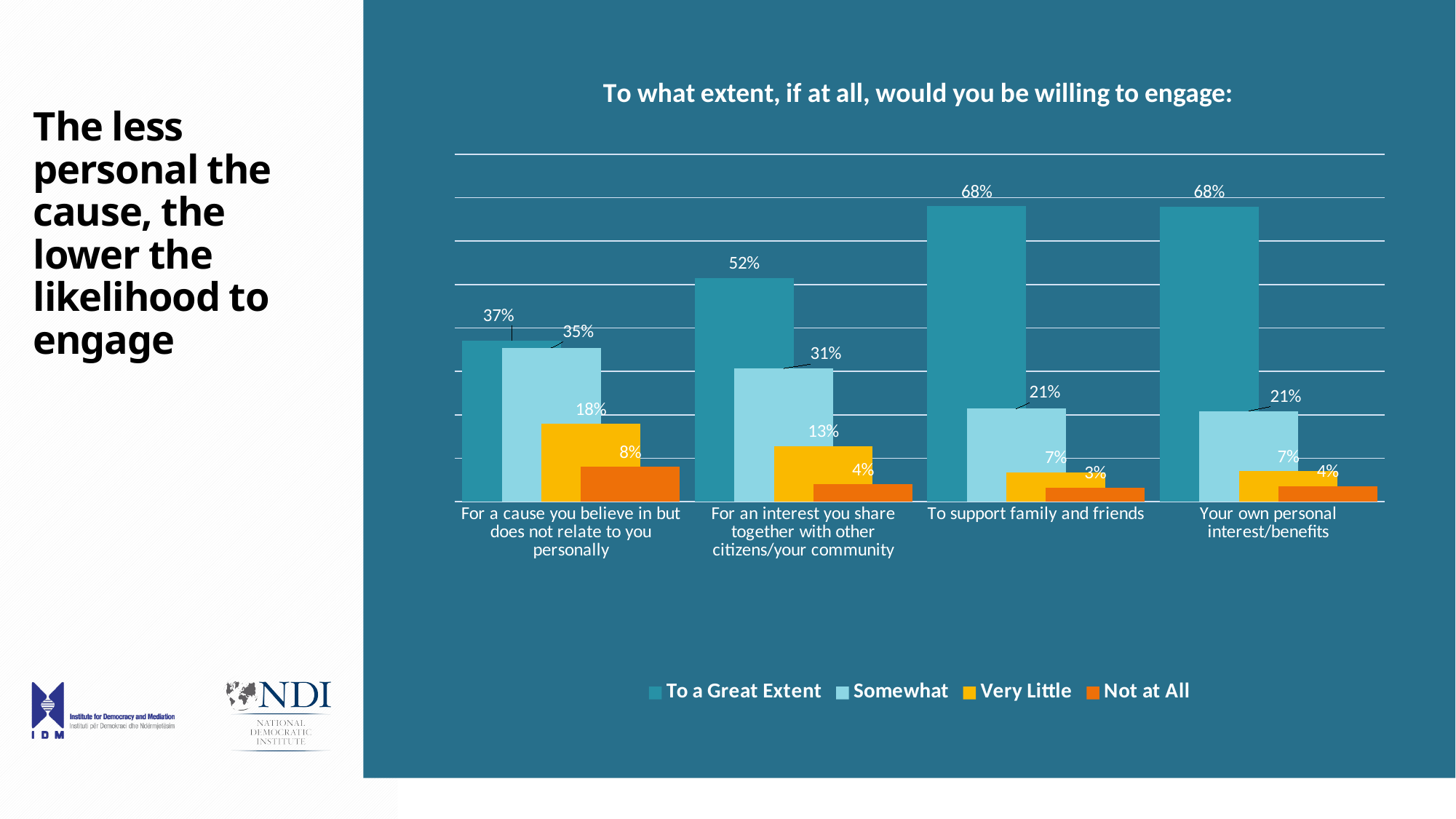
How many series does the legend list? 4 What is the 'Somewhat' value for 'For a cause you believe in but does not relate to you personally'? 35% Which category has the lowest 'To a Great Extent' value? For a cause you believe in but does not relate to you personally What is the title of the chart? To what extent, if at all, would you be willing to engage: Which is larger: the 'Somewhat' value for 'For an interest you share together with other citizens/your community' or the 'Somewhat' value for 'To support family and friends'? For an interest you share together with other citizens/your community What is the 'Not at All' value for 'Your own personal interest/benefits'? 4% How many categories are shown on the x axis? 4 What percentage of respondents would engage 'To a Great Extent' to support family and friends? 68% What is the 'Very Little' value for 'For an interest you share together with other citizens/your community'? 13% Which category has the highest 'Not at All' value? For a cause you believe in but does not relate to you personally What is the difference between the 'To a Great Extent' values for 'To support family and friends' and 'For a cause you believe in but does not relate to you personally'? 31 percentage points What kind of chart is shown on the slide? Bar chart